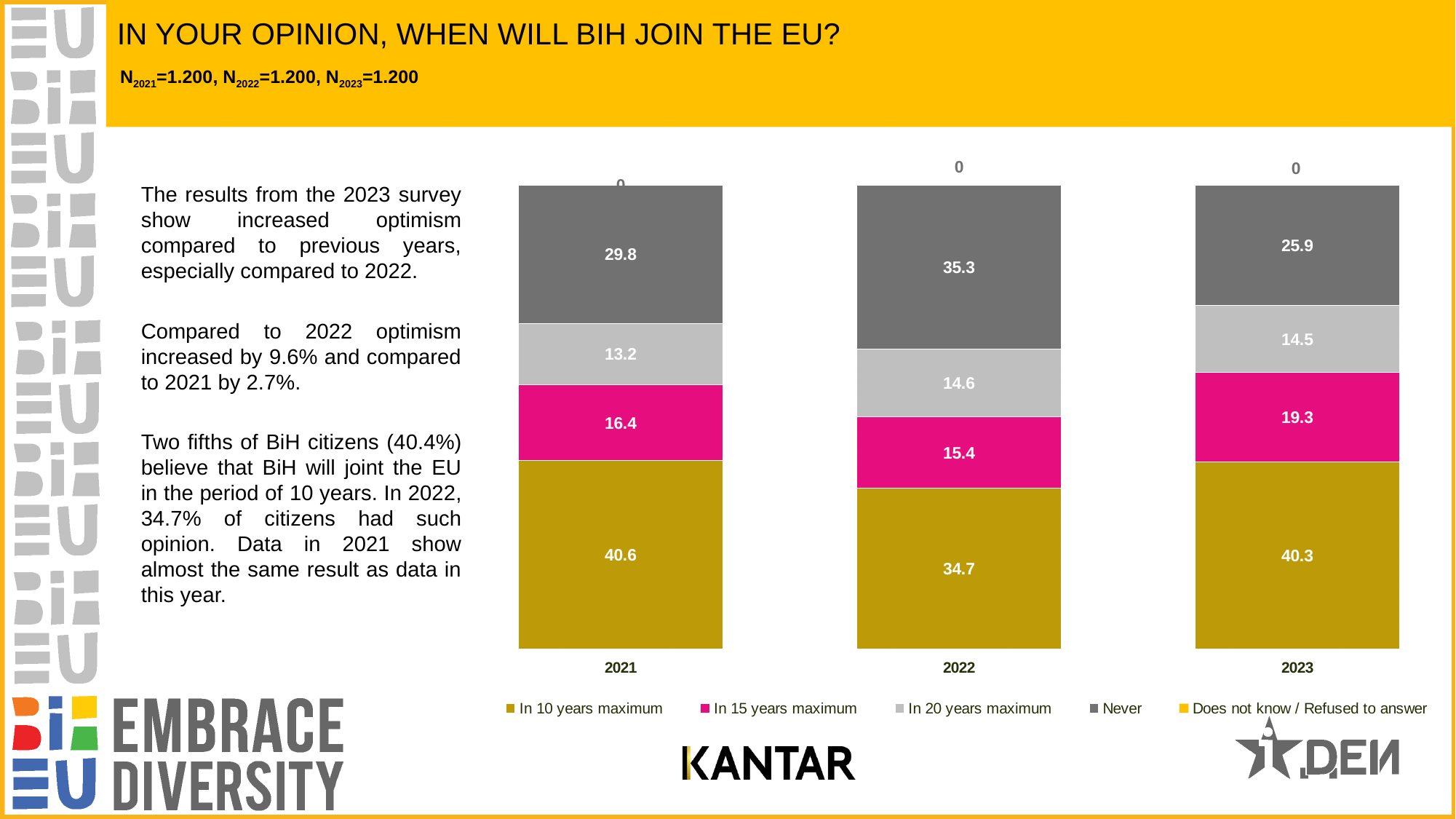
Which is larger: the "In 15 years maximum" value in 2023 or in 2022? 2023 What is the value for "In 15 years maximum" in 2021? 16.4 What is the value for "In 20 years maximum" in 2023? 14.5 What kind of chart is shown on the slide? Stacked bar chart How many series does the legend list? 5 What is the difference between the "In 10 years maximum" values for 2021 and 2022? 5.9 In which year is the value for "Never" the highest? 2022 What is the value for "In 10 years maximum" in 2023? 40.3 In which year is the value for "In 10 years maximum" the lowest? 2022 What is the value for "Does not know / Refused to answer" in 2021? 0 How many years (categories) are shown on the x axis? 3 What is the value for "Never" in 2022? 35.3